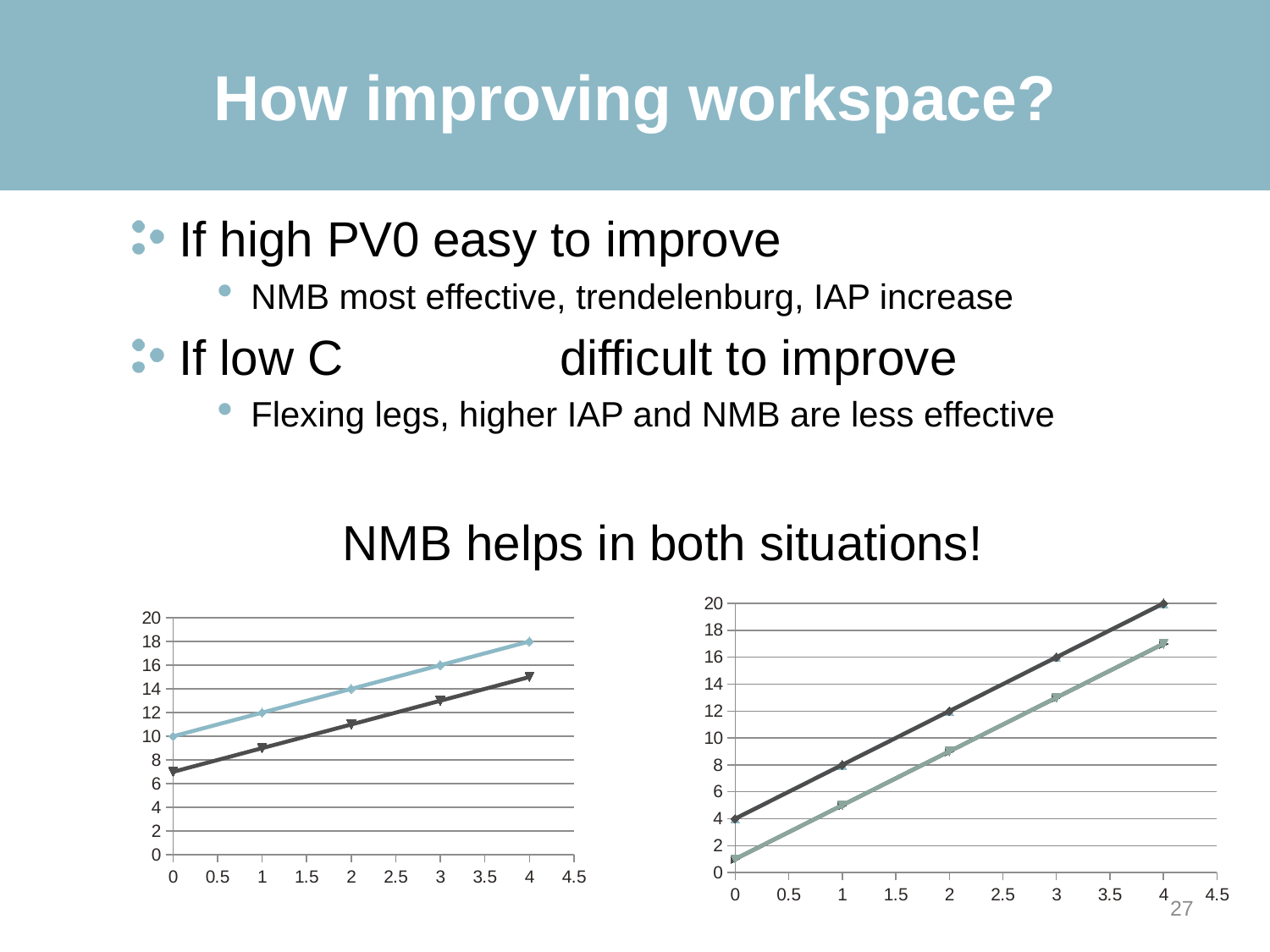
In the chart on the left, what is the value of the light blue line at x = 0? 10 In the chart on the right, at x = 3, which line has the larger value, the dark line or the lighter grey line? the dark line In the chart on the left, how many data points does the light blue line have? 5 In the chart on the right, what is the value of the dark line at x = 0? 4 In the chart on the right, what is the value of the dark line at x = 4? 20 In the chart on the left, what is the value of the light blue line at x = 4? 18 In the chart on the left, how many lines are plotted? 2 In the chart on the right, is the value of the lighter grey line at x = 4 greater or less than 16? greater What kind of chart is the chart on the left of the slide? line chart In the chart on the left, at x = 2, which line has the larger value, the light blue line or the dark line? the light blue line In the chart on the left, do the values of the light blue line rise or fall as x increases? rise In the chart on the left, is the value of the dark line at x = 0 greater or less than 8? less